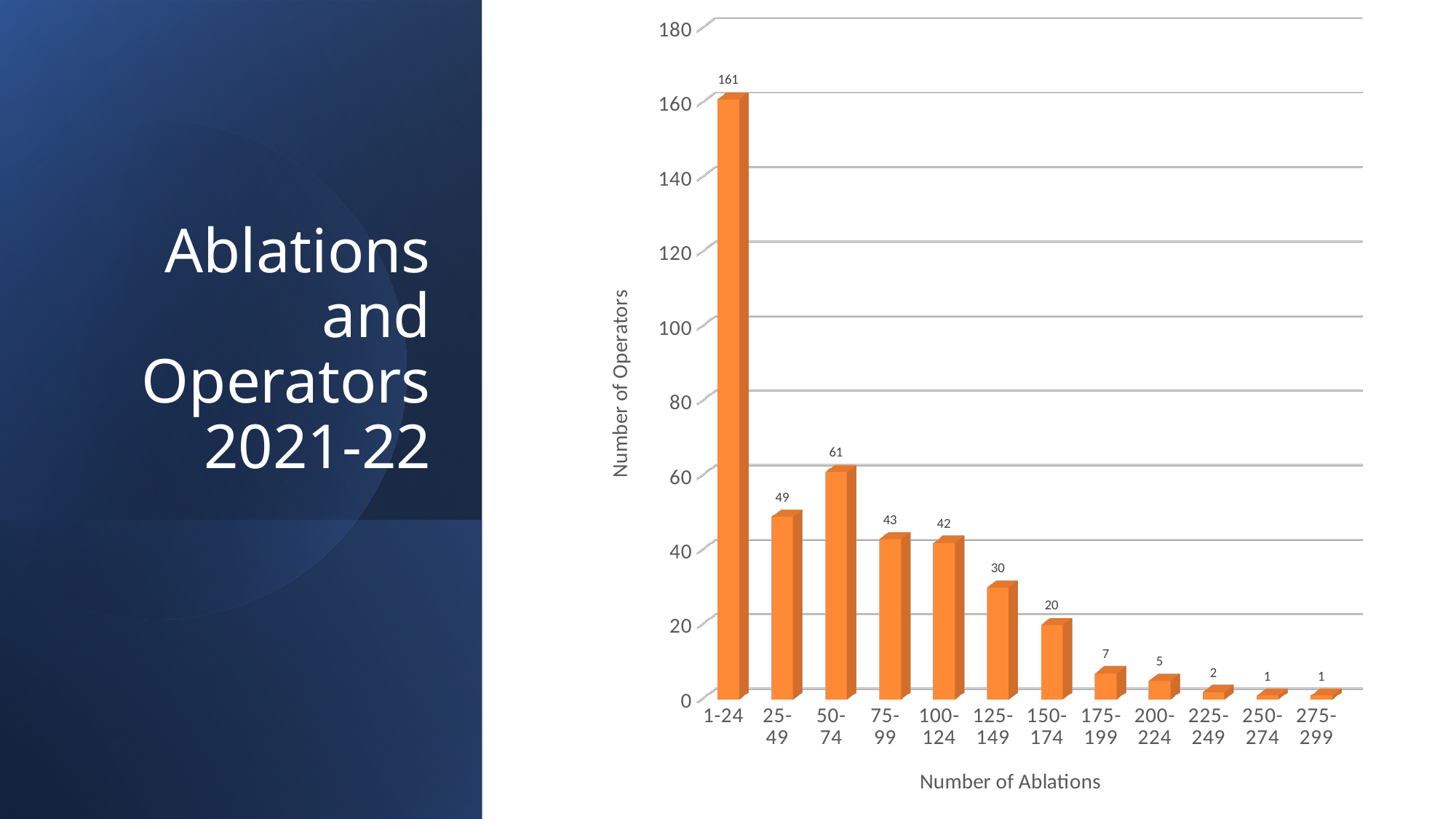
What kind of chart is shown on the slide? Bar chart What is the label of the y axis? Number of Operators Do the number of operators generally rise or fall as the number of ablations increases from 50-74 onward? Fall Which ablation range has the highest number of operators? 1-24 What is the difference in number of operators between the 25-49 and 50-74 categories? 12 What is the label of the x axis? Number of Ablations What is the number of operators in the 50-74 ablations category? 61 How many ablation range categories are shown on the x axis? 12 Which ablation range has the lowest number of operators? 250-274 and 275-299 How many operators are in the 150-174 ablations category? 20 Which category has more operators, 75-99 or 100-124? 75-99 How many operators performed 1-24 ablations? 161